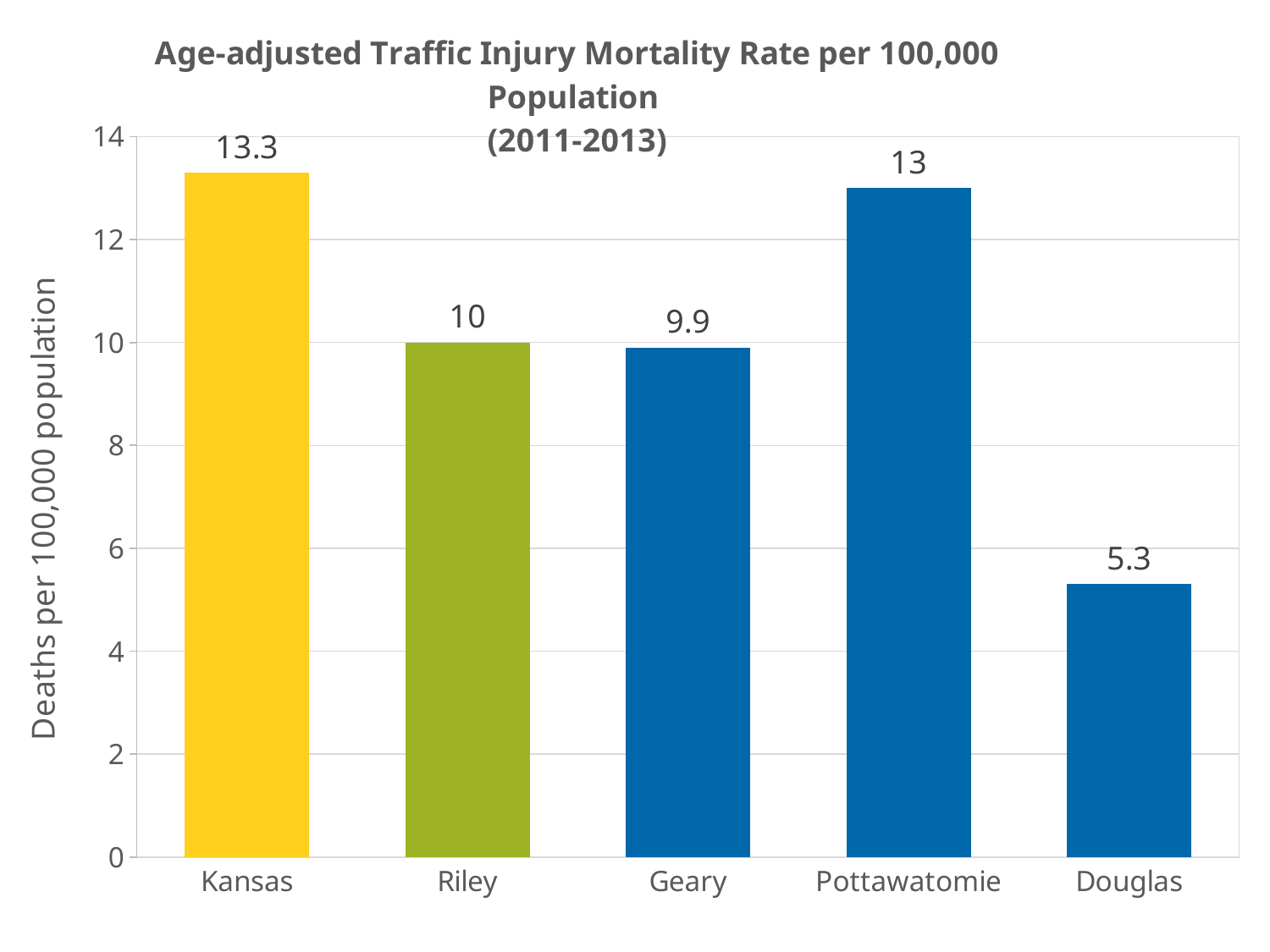
What is the difference between the values for Pottawatomie and Riley? 3 What kind of chart is shown on the slide? bar chart Which category has the highest traffic injury mortality rate? Kansas How many categories are shown on the x axis? 5 Which has a higher mortality rate, Pottawatomie or Geary? Pottawatomie What is the difference between the values for Kansas and Douglas? 8 What is the age-adjusted traffic injury mortality rate for Douglas? 5.3 Is the value for Douglas greater or less than 6? less Which category has the lowest traffic injury mortality rate? Douglas What is the label of the y axis? Deaths per 100,000 population What is the age-adjusted traffic injury mortality rate for Kansas? 13.3 What is the value shown for Geary? 9.9